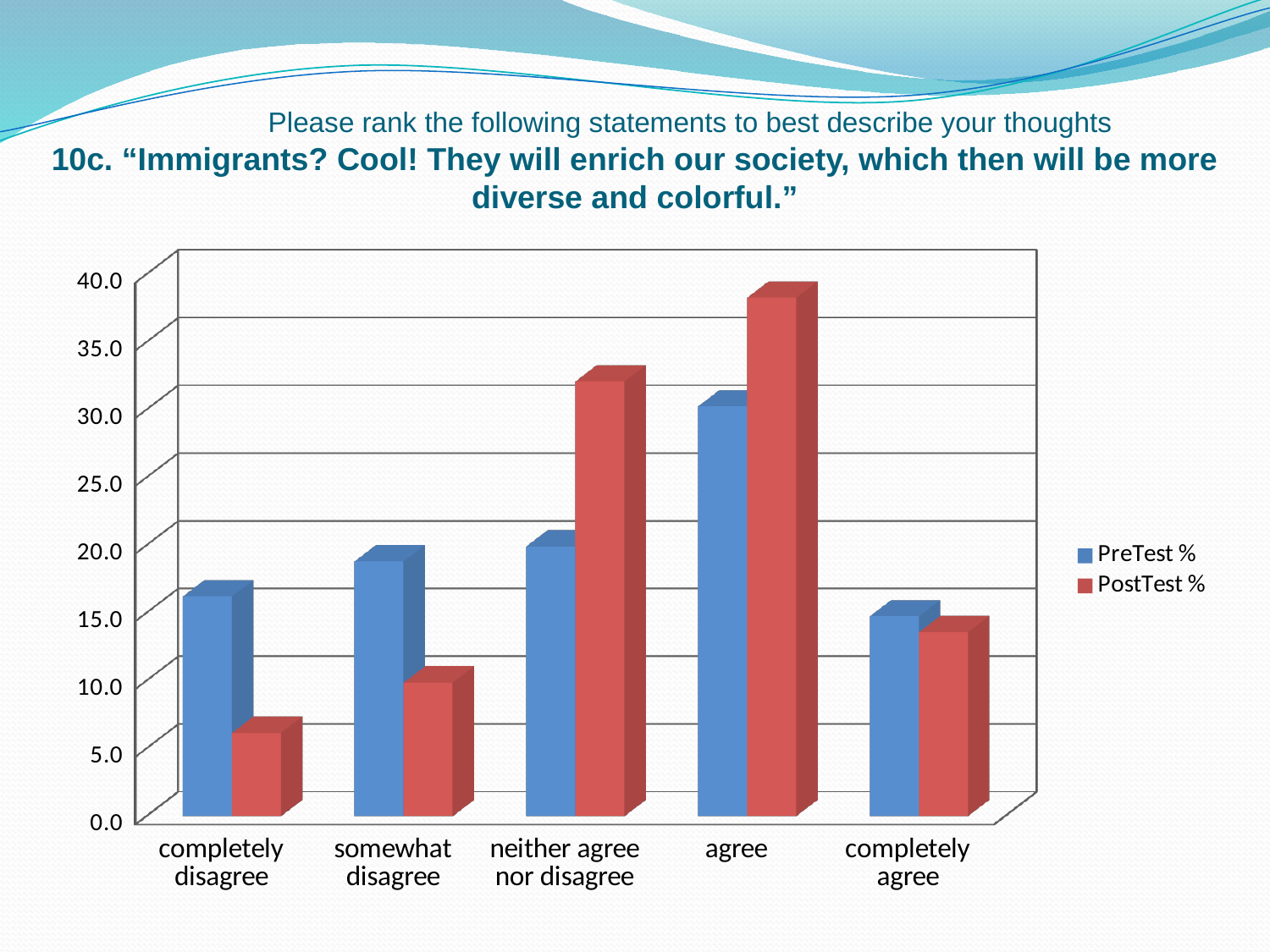
How many series does the legend list? 2 Which category has the highest PreTest % value? agree For the 'neither agree nor disagree' category, which is larger: PreTest % or PostTest %? PostTest % Is the PostTest % value for 'completely disagree' greater or less than 10.0? less What kind of chart is shown on the slide? bar chart Which category has the lowest PostTest % value? completely disagree Is the PostTest % value for 'agree' greater or less than 35.0? greater Which category has the highest PostTest % value? agree How many response categories are shown on the x axis? 5 For the 'completely disagree' category, which is larger: PreTest % or PostTest %? PreTest % What are the two series names listed in the legend? PreTest % and PostTest % For the 'agree' category, which is larger: PreTest % or PostTest %? PostTest %